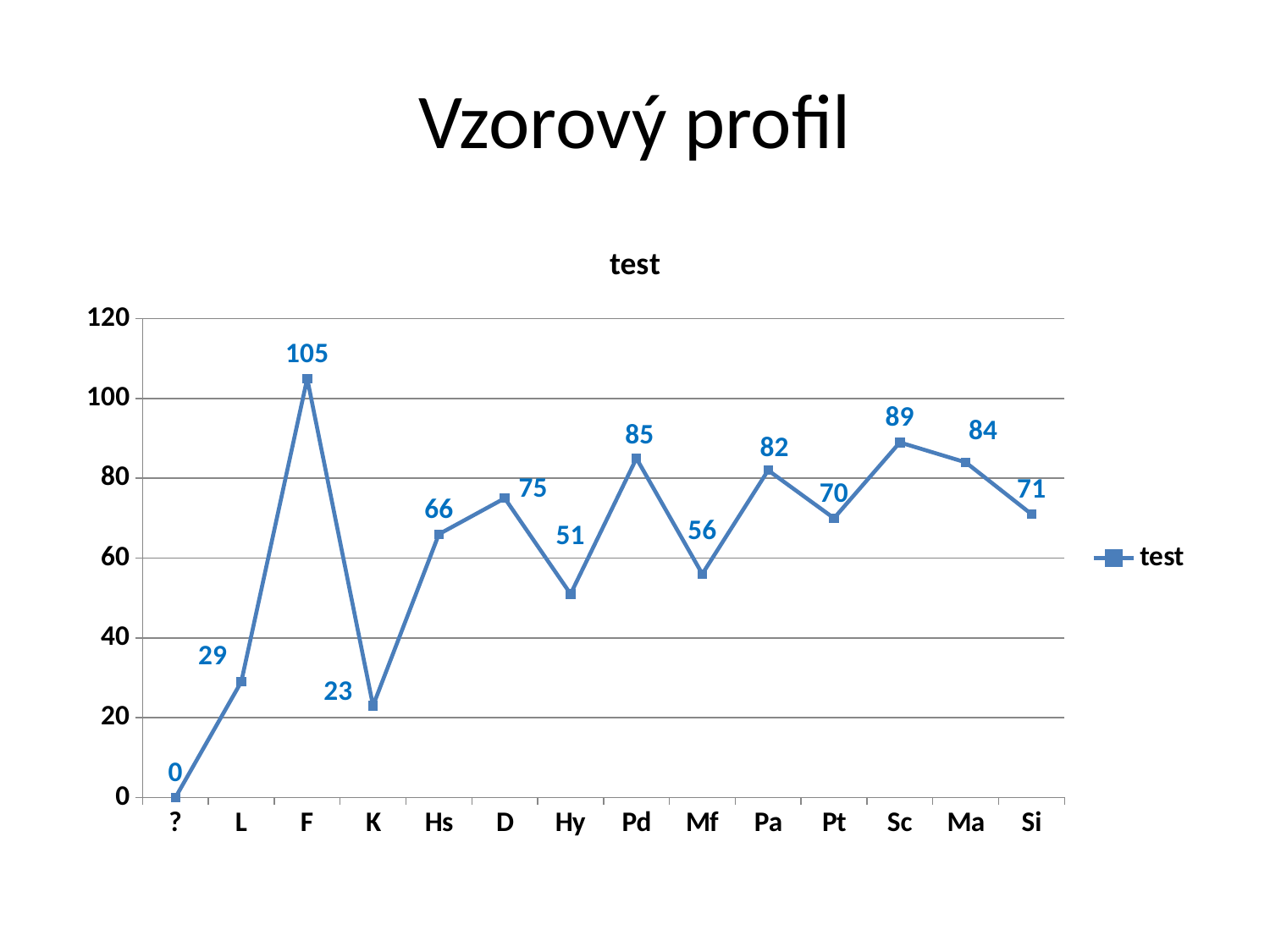
Which category has the lowest value? ? How many series does the legend list? 1 Which is larger, the value for Pd or the value for Pa? Pd What is the value for Sc? 89 What is the difference between the values for F and K? 82 What is the value for Hy? 51 What kind of chart is shown? line chart What is the value for F? 105 Which category has the highest value? F What is the title of the chart? test Is the value for Ma greater or less than 80? greater How many categories are shown on the x axis? 14